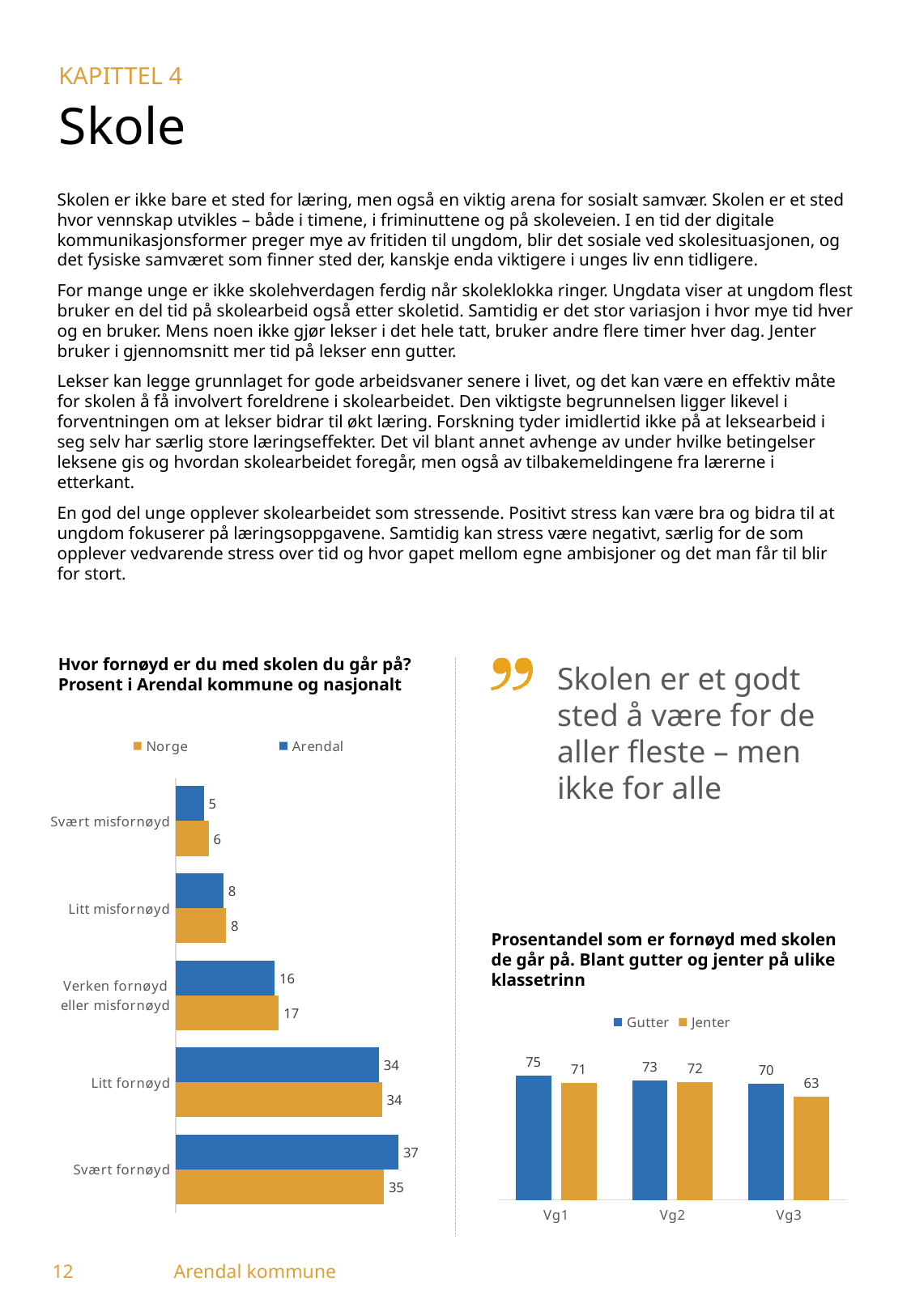
In the chart 'Hvor fornøyd er du med skolen du går på?', which category has the lowest value for Arendal? Svært misfornøyd In the chart 'Prosentandel som er fornøyd med skolen de går på', what is the difference between Gutter and Jenter at Vg3? 7 In the chart 'Prosentandel som er fornøyd med skolen de går på', do the Jenter values rise or fall from Vg1 to Vg3? Fall In the chart 'Hvor fornøyd er du med skolen du går på?', what is the value for Norge in the category 'Verken fornøyd eller misfornøyd'? 17 In the chart 'Hvor fornøyd er du med skolen du går på?', what is the value for Arendal in the category 'Svært fornøyd'? 37 In the chart 'Hvor fornøyd er du med skolen du går på?', what is the difference between the Arendal and Norge values for 'Svært fornøyd'? 2 In the chart 'Hvor fornøyd er du med skolen du går på?', how many series does the legend list? 2 In the chart 'Prosentandel som er fornøyd med skolen de går på', which colour represents Gutter? Blue In the chart 'Hvor fornøyd er du med skolen du går på?', how many categories are shown? 5 What kind of chart is 'Hvor fornøyd er du med skolen du går på?'? Bar chart In the chart 'Prosentandel som er fornøyd med skolen de går på', which klassetrinn has the highest value for Gutter? Vg1 In the chart 'Prosentandel som er fornøyd med skolen de går på', what is the value for Jenter at Vg3? 63